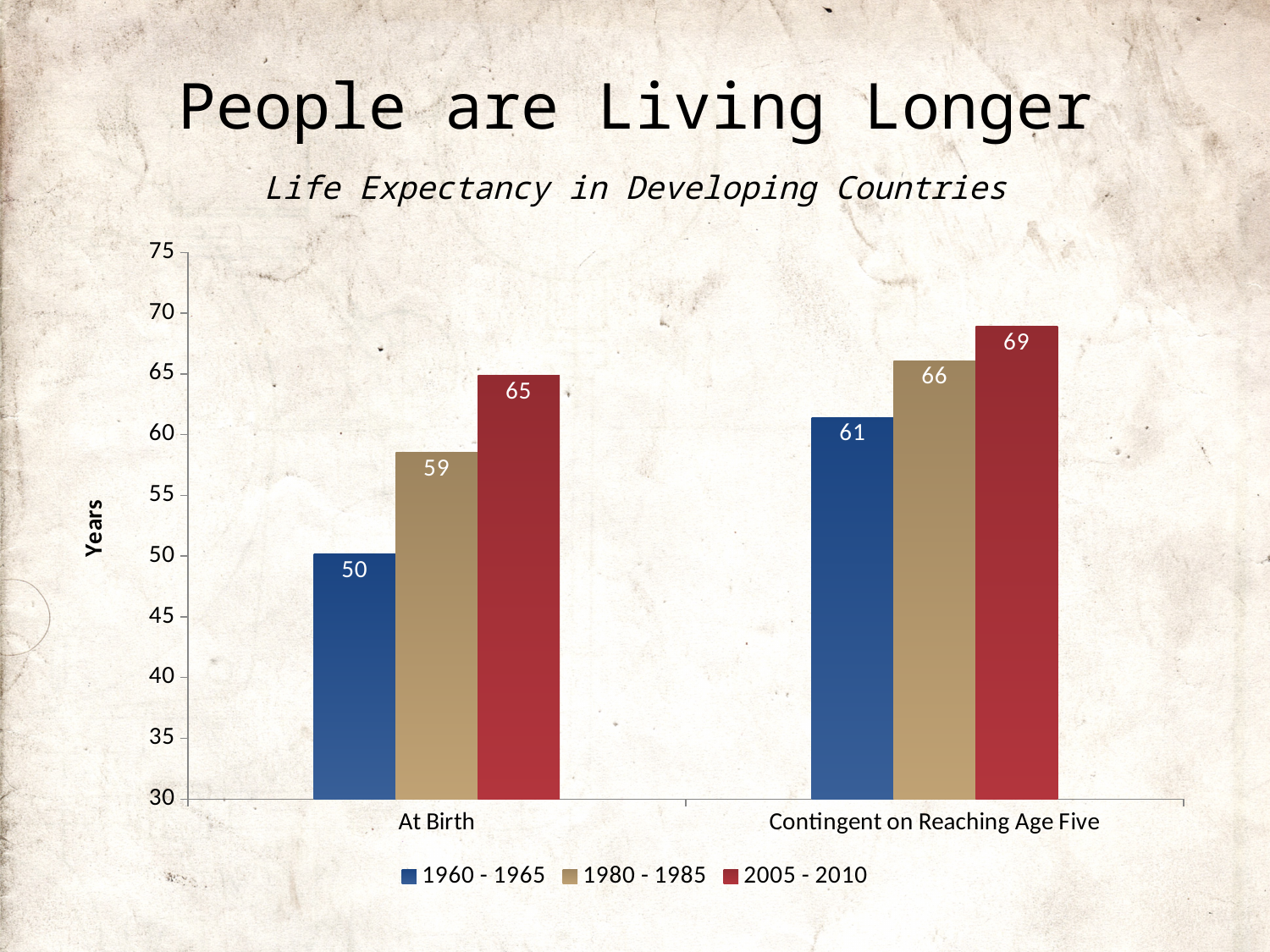
What kind of chart is shown on the slide? Bar chart What is the difference between the Contingent on Reaching Age Five and At Birth values for 1980 - 1985? 7 How many series does the legend list? 3 What is the label of the vertical axis? Years What is the difference between the 2005 - 2010 and 1960 - 1965 values in the At Birth category? 15 What is the value for 1960 - 1965 in the Contingent on Reaching Age Five category? 61 Which is larger: the 2005 - 2010 value at birth or the 1980 - 1985 value contingent on reaching age five? 1980 - 1985 contingent on reaching age five Which series has the lowest value in the Contingent on Reaching Age Five category? 1960 - 1965 What is the life expectancy at birth for 1960 - 1965? 50 Which series has the highest value in the At Birth category? 2005 - 2010 What is the value for 1980 - 1985 in the At Birth category? 59 What is the life expectancy contingent on reaching age five for 2005 - 2010? 69